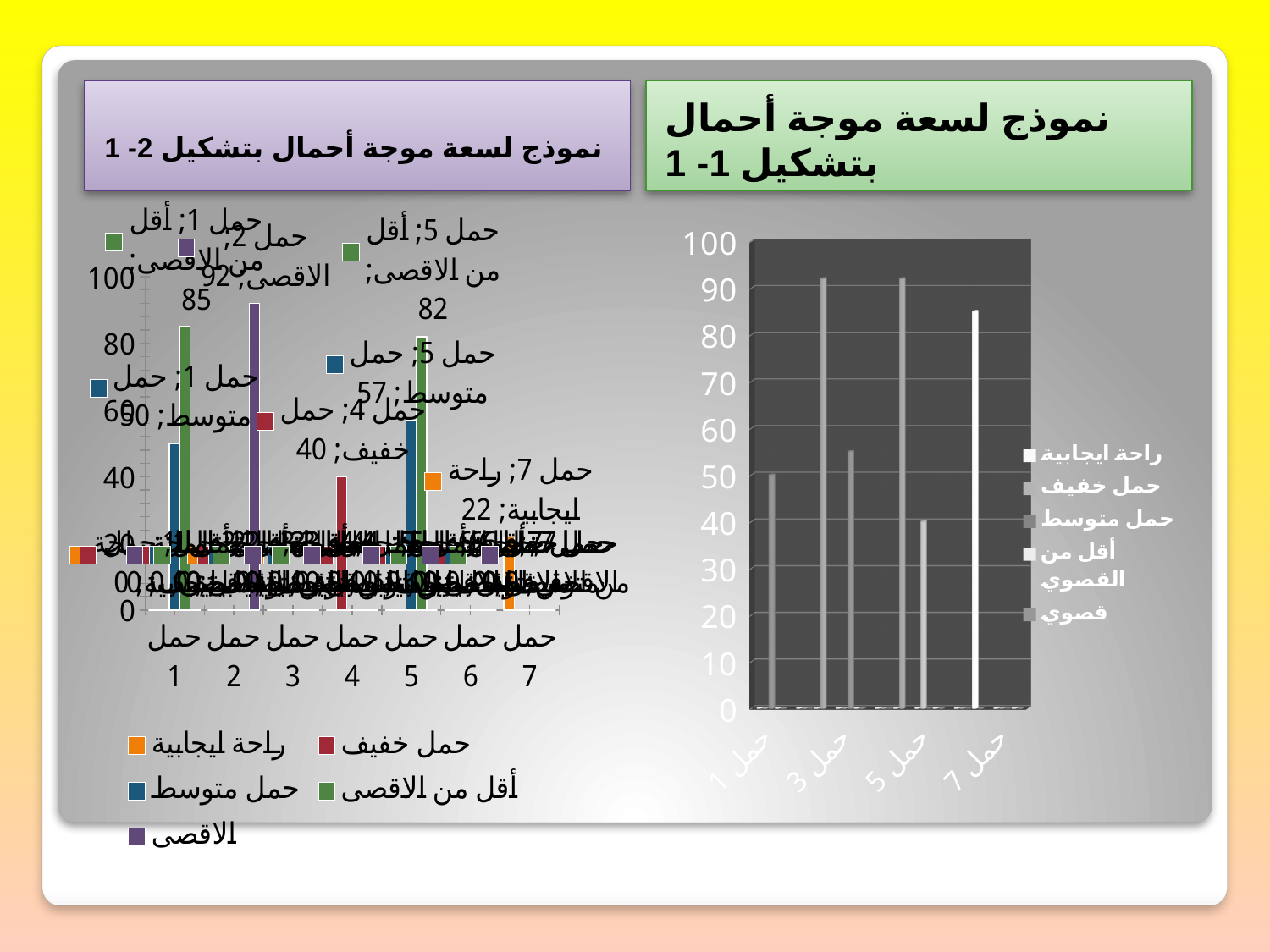
In the left chart ("نموذج لسعة موجة أحمال بتشكيل 2-1"), what is the value labelled for حمل 7, راحة ايجابية? 22 In the left chart ("نموذج لسعة موجة أحمال بتشكيل 2-1"), what is the value labelled for حمل 2, الاقصى? 92 In the right chart ("نموذج لسعة موجة أحمال بتشكيل 1-1"), is the value of the first bar at حمل 1 greater or less than 60? less How many series does the legend of the right chart ("نموذج لسعة موجة أحمال بتشكيل 1-1") list? 5 What kind of chart is the chart titled "نموذج لسعة موجة أحمال بتشكيل 1-1" on the right? bar chart In the left chart ("نموذج لسعة موجة أحمال بتشكيل 2-1"), what is the value labelled for حمل 4, حمل خفيف? 40 In the left chart ("نموذج لسعة موجة أحمال بتشكيل 2-1"), which is larger: the حمل 1 حمل متوسط value or the حمل 4 حمل خفيف value? حمل 1 حمل متوسط (50) In the left chart ("نموذج لسعة موجة أحمال بتشكيل 2-1"), what is the difference between the حمل 5 أقل من الاقصى value (82) and the حمل 5 حمل متوسط value (57)? 25 How many categories (حمل) are shown on the x axis of the left chart ("نموذج لسعة موجة أحمال بتشكيل 2-1")? 7 In the right chart ("نموذج لسعة موجة أحمال بتشكيل 1-1"), what is the highest value shown on the vertical axis? 100 In the left chart ("نموذج لسعة موجة أحمال بتشكيل 2-1"), what is the value labelled for حمل 1, أقل من الاقصى? 85